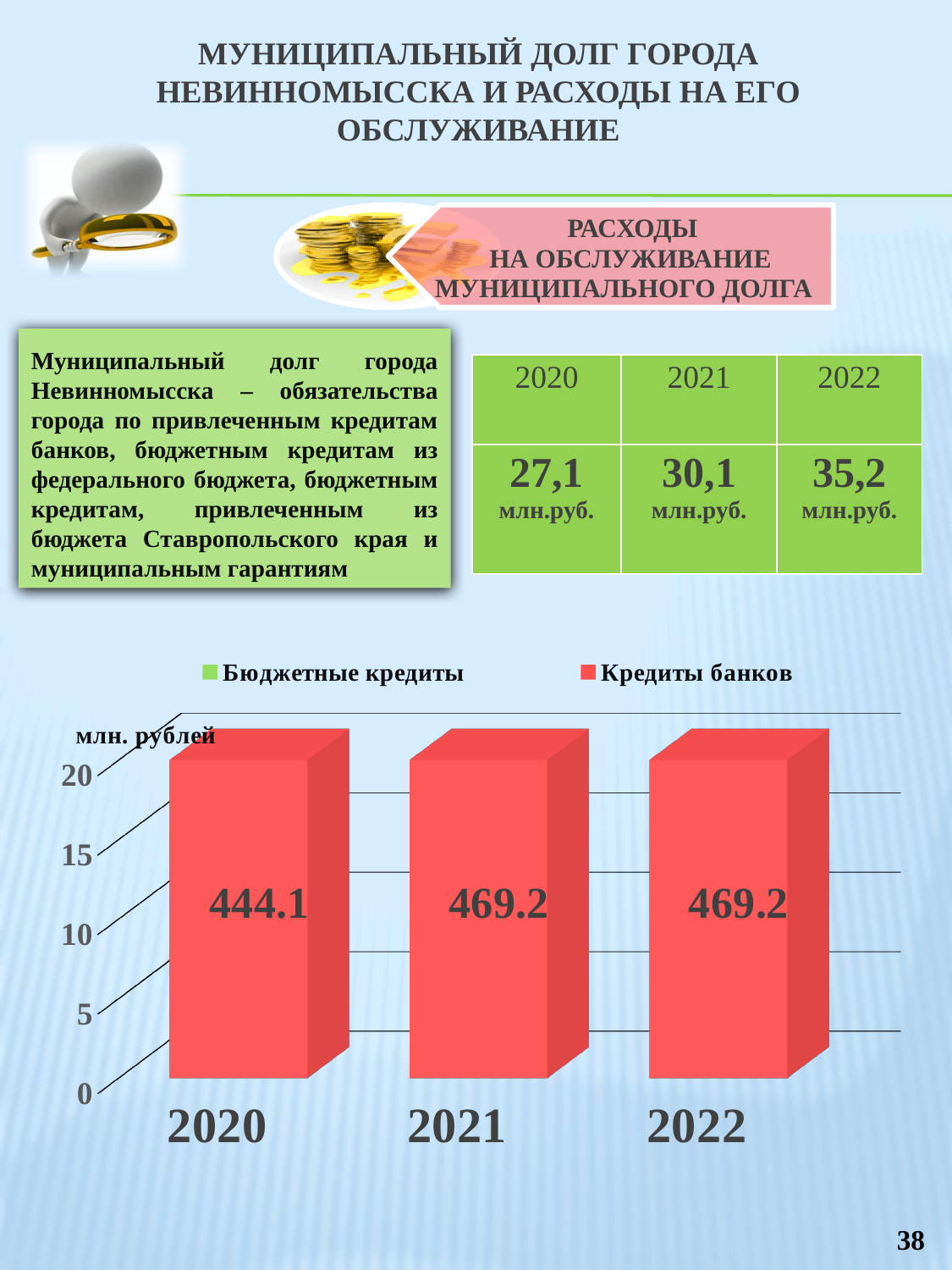
How many series does the chart legend list? 2 Does the Кредиты банков value rise or fall from 2020 to 2021? rise What is the value of Кредиты банков for 2022? 469.2 What kind of chart is shown on the slide? bar chart How many years are shown on the x axis of the chart? 3 What unit label is shown on the vertical axis of the chart? млн. рублей What is the value of Кредиты банков for 2021? 469.2 What is the difference between the Кредиты банков values for 2021 and 2020? 25.1 What are the two series named in the chart legend? Бюджетные кредиты and Кредиты банков Which is larger, the Кредиты банков value for 2020 or for 2021? 2021 What is the value of Кредиты банков for 2020? 444.1 Which year has the lowest value for Кредиты банков? 2020